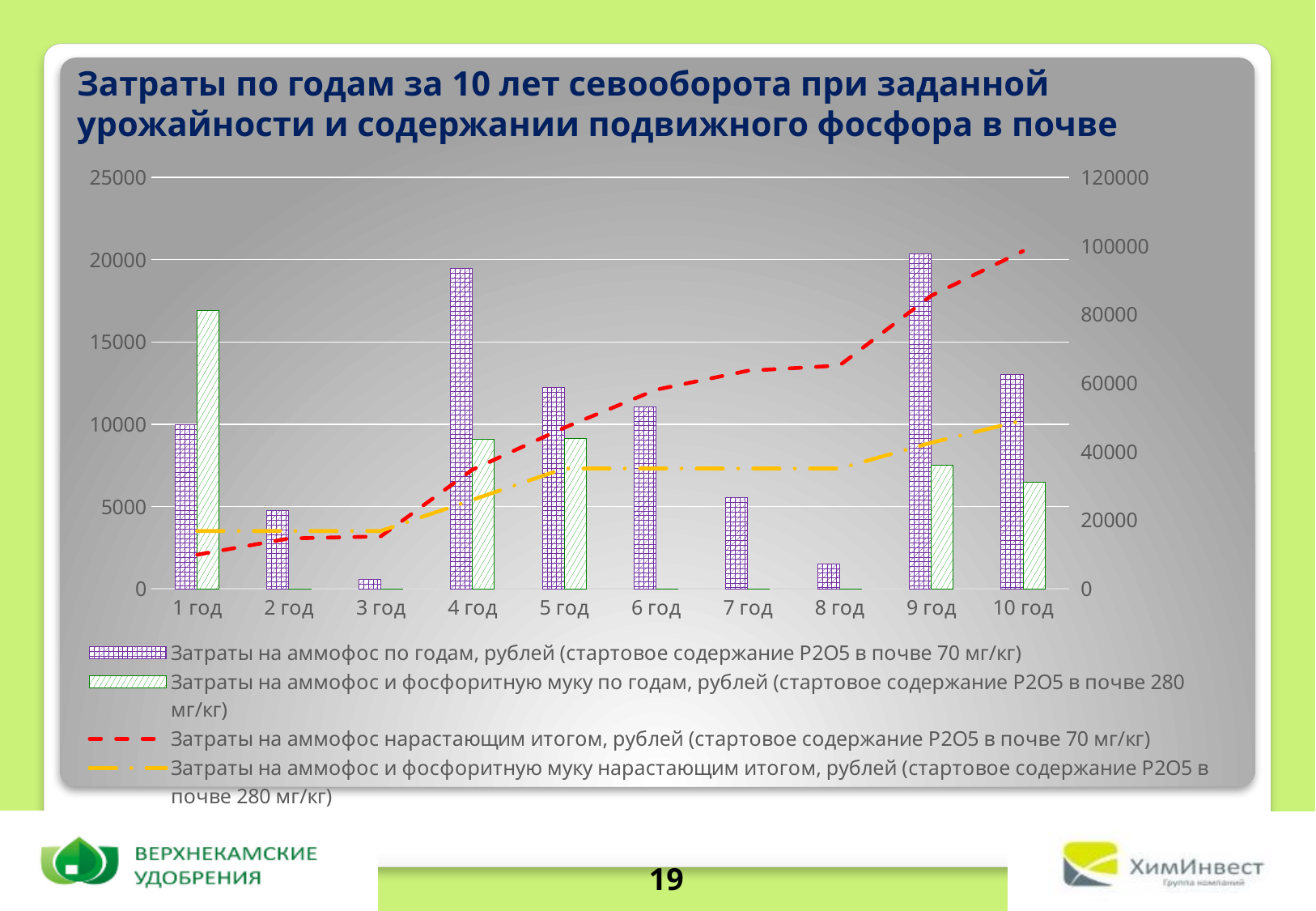
Is the value for 'Затраты на аммофос по годам' (70 мг/кг) in 4 год greater or less than 15000? greater How many series does the legend list? 4 In which year is the bar for 'Затраты на аммофос по годам, рублей (стартовое содержание P2O5 в почве 70 мг/кг)' the lowest? 3 год What kind of chart is shown on the slide? A combined bar and line chart Is the value for 'Затраты на аммофос по годам' (70 мг/кг) in 8 год greater or less than 5000? less In 1 год, which bar is larger: 'Затраты на аммофос по годам' (70 мг/кг) or 'Затраты на аммофос и фосфоритную муку по годам' (280 мг/кг)? Затраты на аммофос и фосфоритную муку по годам (280 мг/кг) In which year is the bar for 'Затраты на аммофос по годам, рублей (стартовое содержание P2O5 в почве 70 мг/кг)' the highest? 9 год What colour and style is the line for 'Затраты на аммофос и фосфоритную муку нарастающим итогом'? Yellow dash-dot line In which year is the bar for 'Затраты на аммофос и фосфоритную муку по годам, рублей (стартовое содержание P2O5 в почве 280 мг/кг)' the highest? 1 год Is the value for 'Затраты на аммофос и фосфоритную муку по годам' (280 мг/кг) in 1 год greater or less than 15000? greater Does the red dashed line 'Затраты на аммофос нарастающим итогом' rise or fall from 1 год to 10 год? Rises How many years (categories) are shown on the x axis? 10